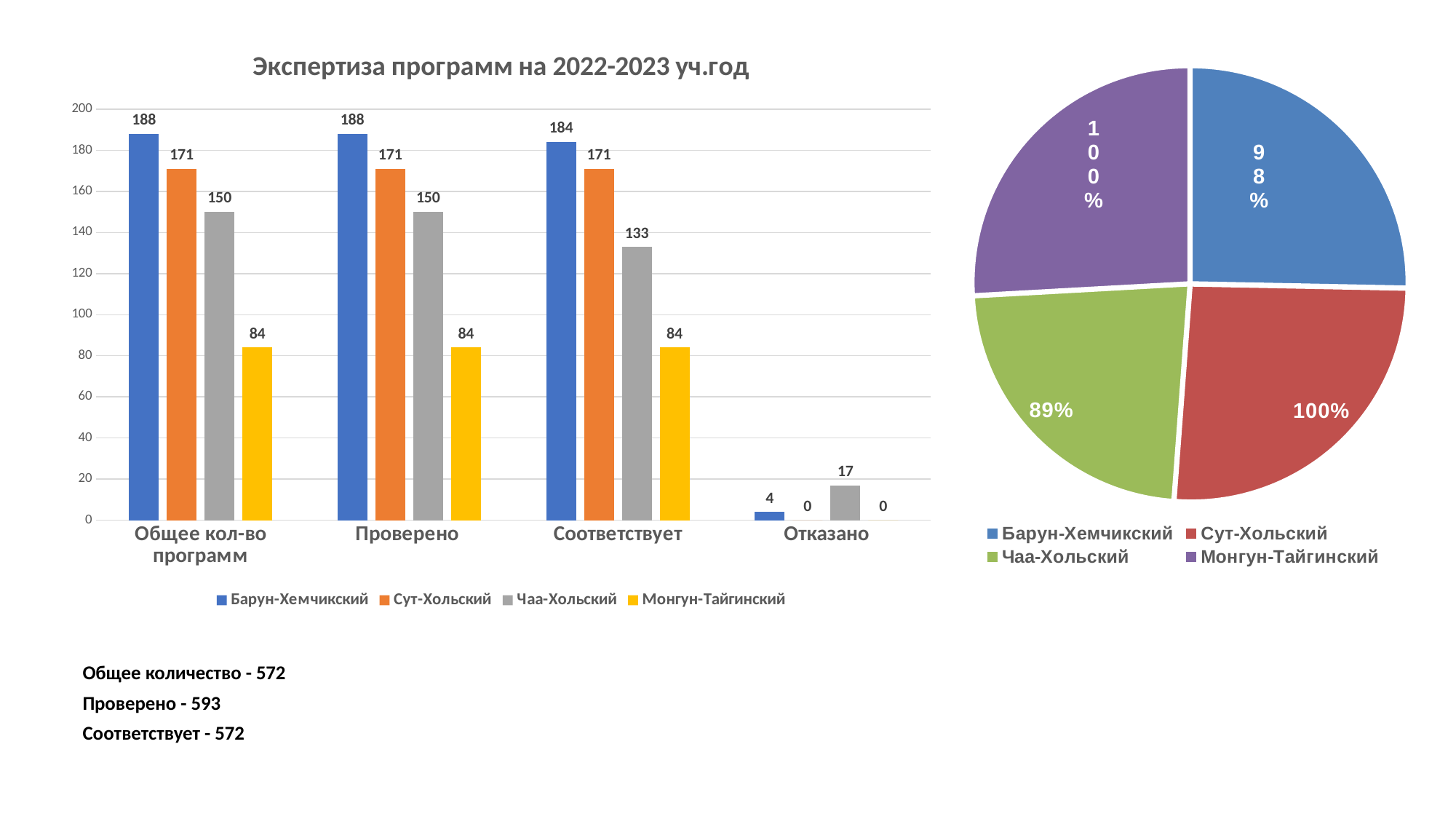
How many categories are shown on the x axis of the bar chart 'Экспертиза программ на 2022-2023 уч.год'? 4 In the bar chart 'Экспертиза программ на 2022-2023 уч.год', what is the difference between the Чаа-Хольский values for 'Проверено' and 'Соответствует'? 17 In the bar chart 'Экспертиза программ на 2022-2023 уч.год', what is the value for Чаа-Хольский in the 'Соответствует' category? 133 In the pie chart on the right, what percentage is shown for the Барун-Хемчикский slice? 98% In the bar chart 'Экспертиза программ на 2022-2023 уч.год', what is the value for Барун-Хемчикский in the 'Общее кол-во программ' category? 188 What kind of chart is the chart on the right side of the slide? Pie chart In the bar chart 'Экспертиза программ на 2022-2023 уч.год', which series has the highest value in the 'Отказано' category? Чаа-Хольский How many series does the legend of the bar chart 'Экспертиза программ на 2022-2023 уч.год' list? 4 In the bar chart 'Экспертиза программ на 2022-2023 уч.год', which series has the lowest value in the 'Проверено' category? Монгун-Тайгинский In the bar chart 'Экспертиза программ на 2022-2023 уч.год', which is larger: Сут-Хольский or Чаа-Хольский in the 'Общее кол-во программ' category? Сут-Хольский In the bar chart 'Экспертиза программ на 2022-2023 уч.год', what is the value for Чаа-Хольский in the 'Отказано' category? 17 In the pie chart on the right, what percentage is shown for the Чаа-Хольский slice? 89%